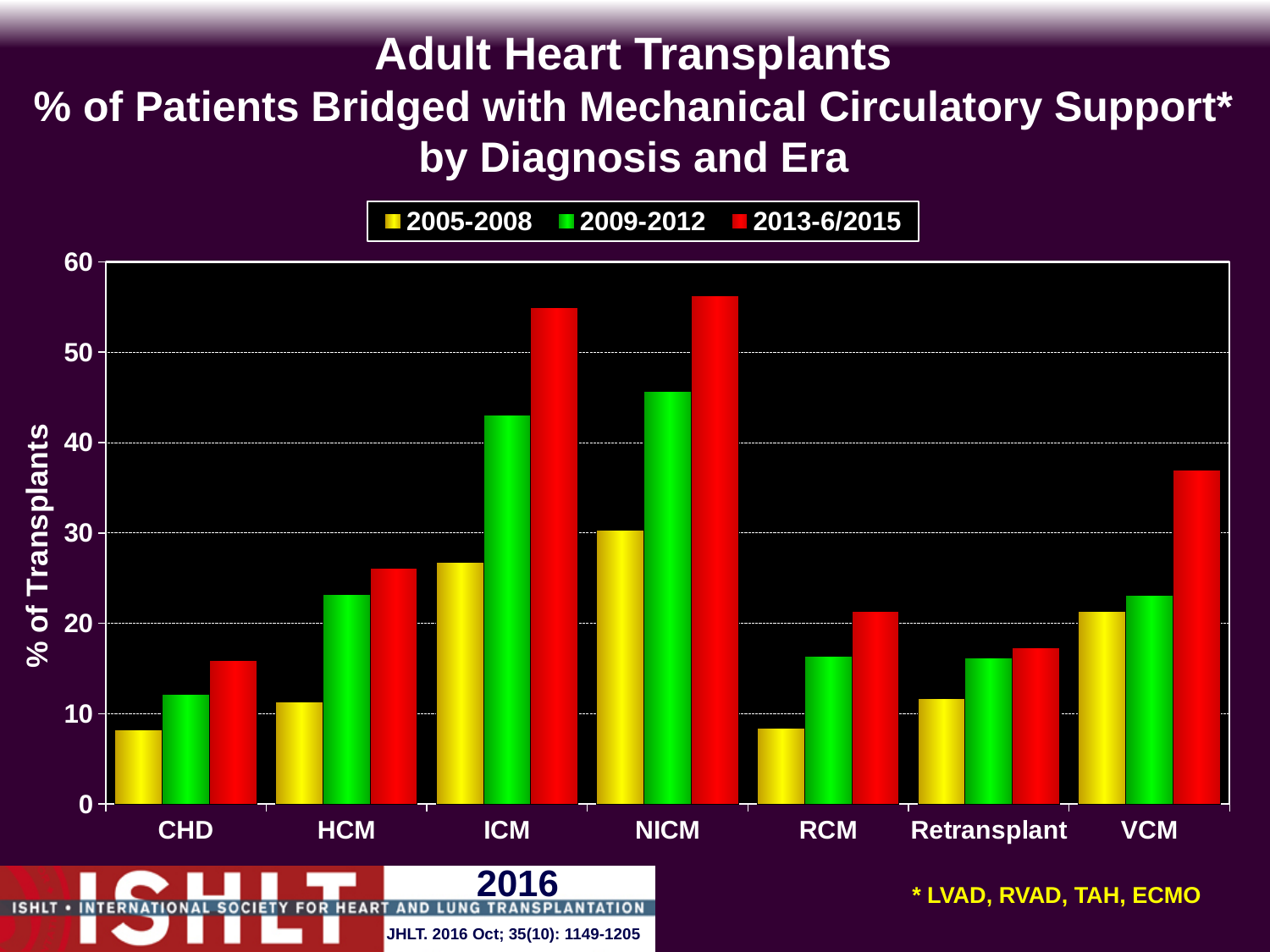
For the 2013-6/2015 era, which is larger: the value for HCM or the value for VCM? VCM What kind of chart is shown on the slide? bar chart Is the value for VCM in the 2013-6/2015 era greater or less than 40? less Which diagnosis has the lowest value for the 2009-2012 era? CHD How many diagnosis categories are shown on the x axis? 7 Which diagnosis has the highest value for the 2009-2012 era? NICM How many series (eras) does the legend list? 3 Is the value for NICM in the 2009-2012 era greater or less than 40? greater Is the value for RCM in the 2005-2008 era greater or less than 10? less What colour represents the 2013-6/2015 era in the legend? red For ICM, do the values rise or fall from the 2005-2008 era to the 2013-6/2015 era? rise